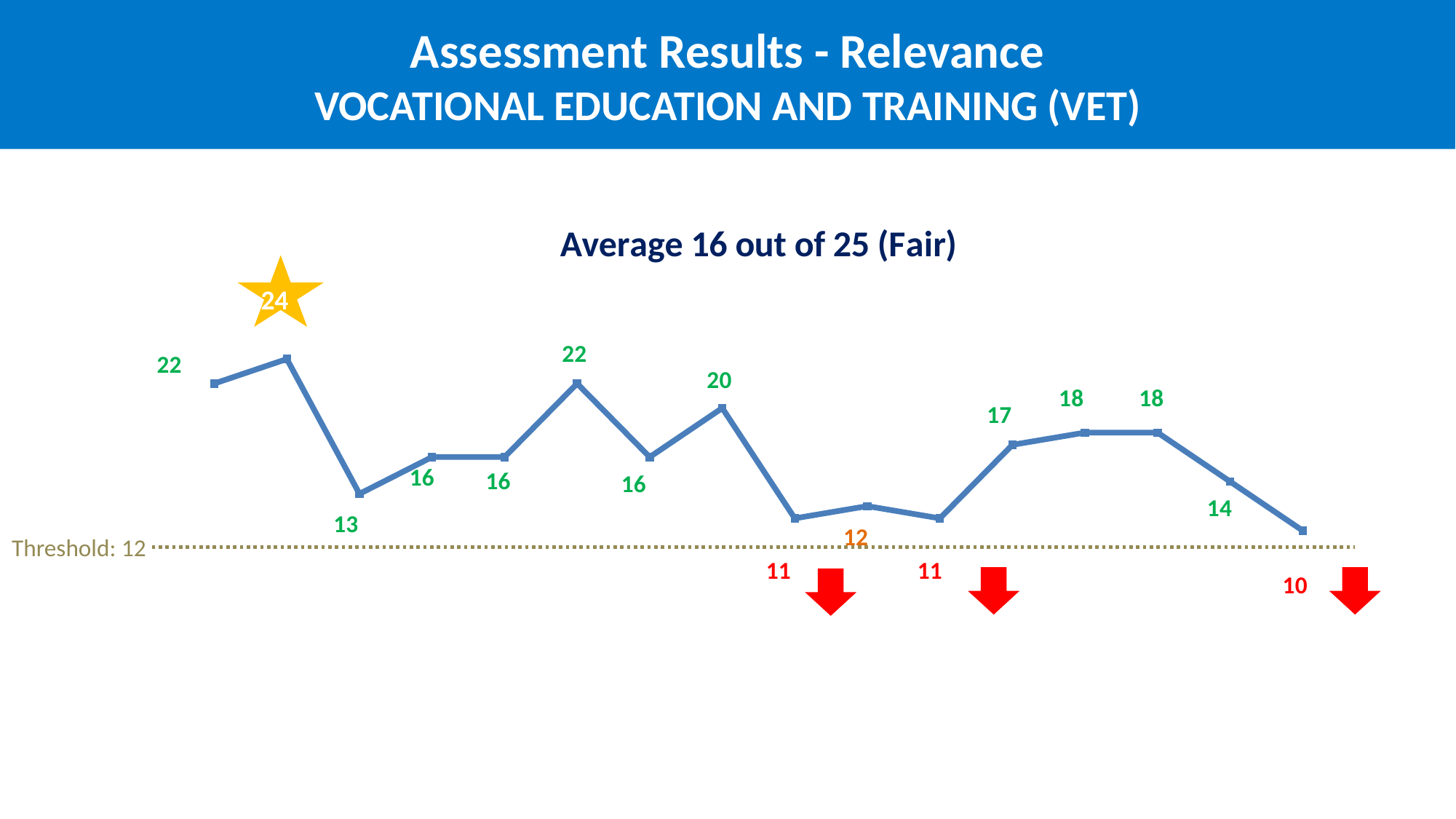
How many data points fall below the threshold of 12 on the line chart? 3 What is the highest value plotted on the line chart? 24 What is the lowest value plotted on the line chart? 10 What is the value of the last data point on the line chart? 10 What average is stated in the chart's title? 16 out of 25 (Fair) What threshold value is marked by the dotted line on the chart? 12 Which is larger: the second data point or the third data point on the line chart? the second data point (24) What is the difference between the highest value (24) and the lowest value (10) on the line chart? 14 What is the value of the third data point on the line chart? 13 What is the value of the first data point on the line chart? 22 How many data points are plotted on the line chart? 16 What kind of chart is shown on the slide? line chart